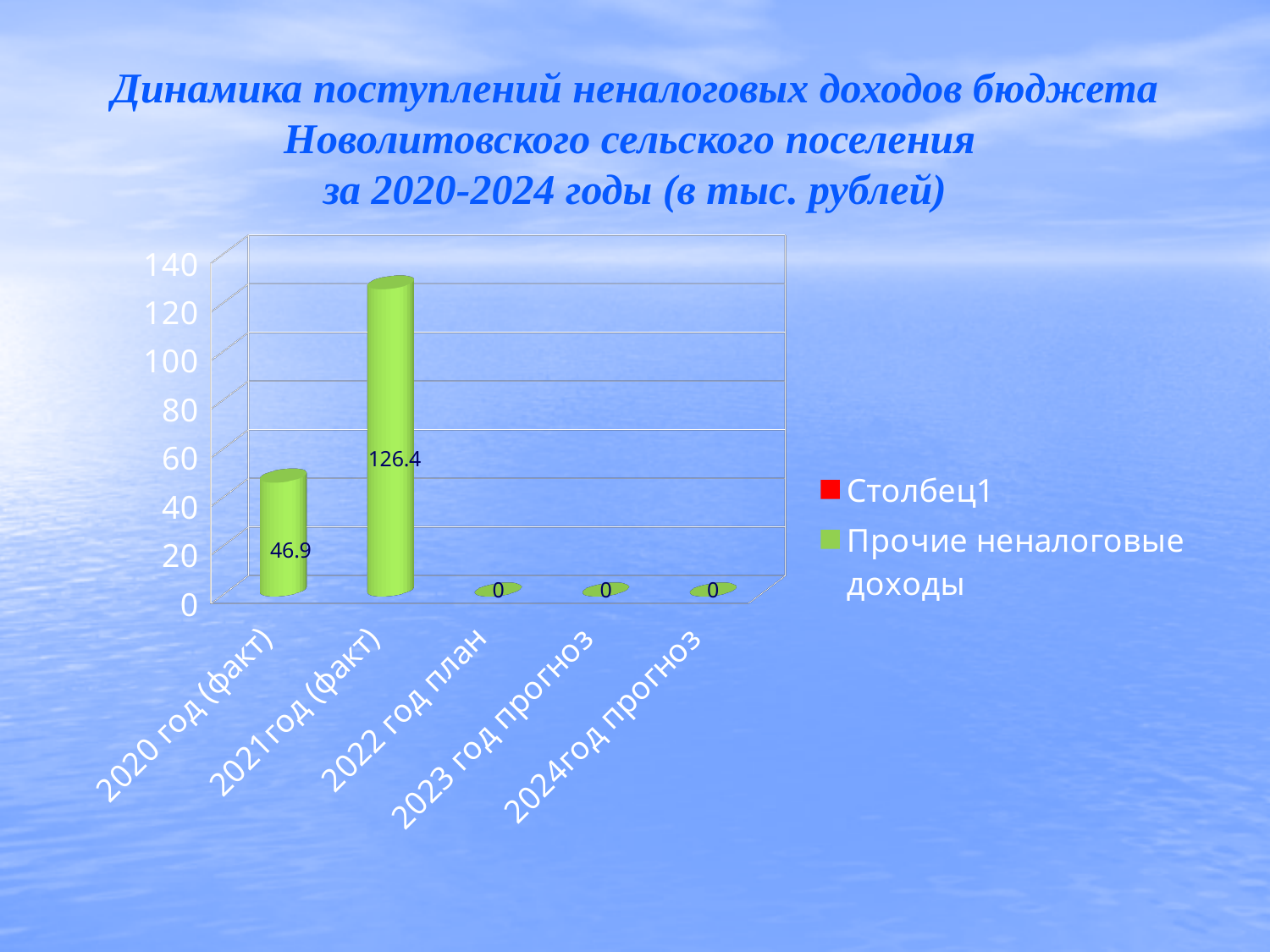
Which category has the highest value? 2021год (факт) Is the value for 2021год (факт) greater or less than 100? greater Which is larger, the value for 2020 год (факт) or the value for 2021год (факт)? 2021год (факт) How many series does the legend list? 2 What is the name of the green series in the legend? Прочие неналоговые доходы Is the value for 2020 год (факт) greater or less than 60? less What is the difference between the values for 2021год (факт) and 2020 год (факт)? 79.5 What is the value for 2023 год прогноз? 0 How many categories are shown on the x axis? 5 What is the value for 2021год (факт)? 126.4 What is the value for 2020 год (факт)? 46.9 What kind of chart is shown on the slide? bar chart